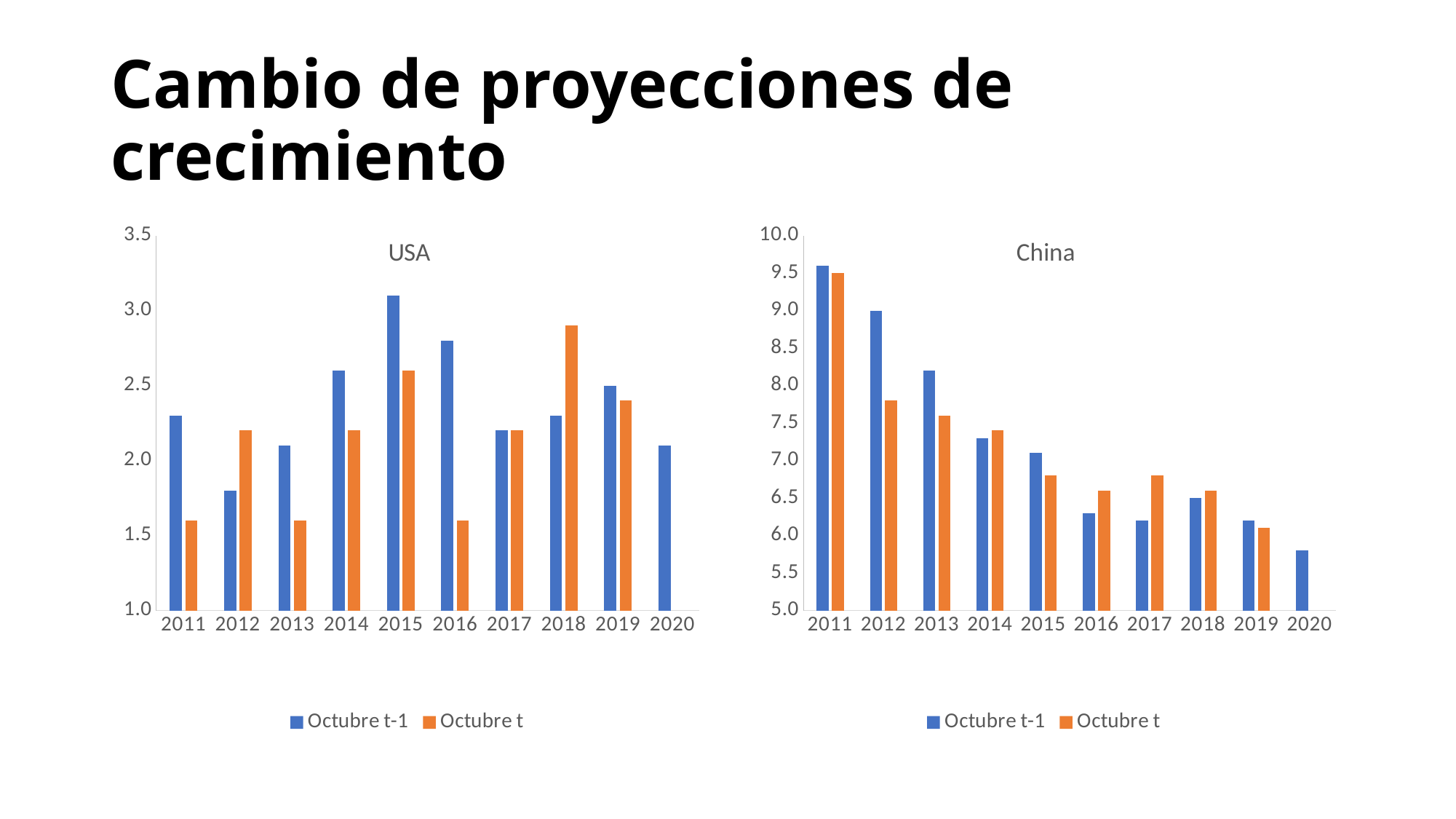
In the China chart, for 2012, which is larger: Octubre t-1 or Octubre t? Octubre t-1 In the China chart, do the Octubre t-1 values generally rise or fall from 2011 to 2020? fall In the China chart, is the Octubre t-1 value for 2011 greater or less than 9.0? greater In the USA chart, which year has the highest Octubre t-1 value? 2015 In the China chart, which year has the highest Octubre t value? 2011 In the USA chart, for 2018, which is larger: Octubre t-1 or Octubre t? Octubre t How many years are shown on the x axis of the USA chart? 10 In the USA chart, which year has the highest Octubre t value? 2018 What kind of chart is the USA chart? bar chart In the China chart, which year has the lowest Octubre t-1 value? 2020 How many series does the legend of the China chart list? 2 In the USA chart, is the Octubre t-1 value for 2015 greater or less than 2.5? greater